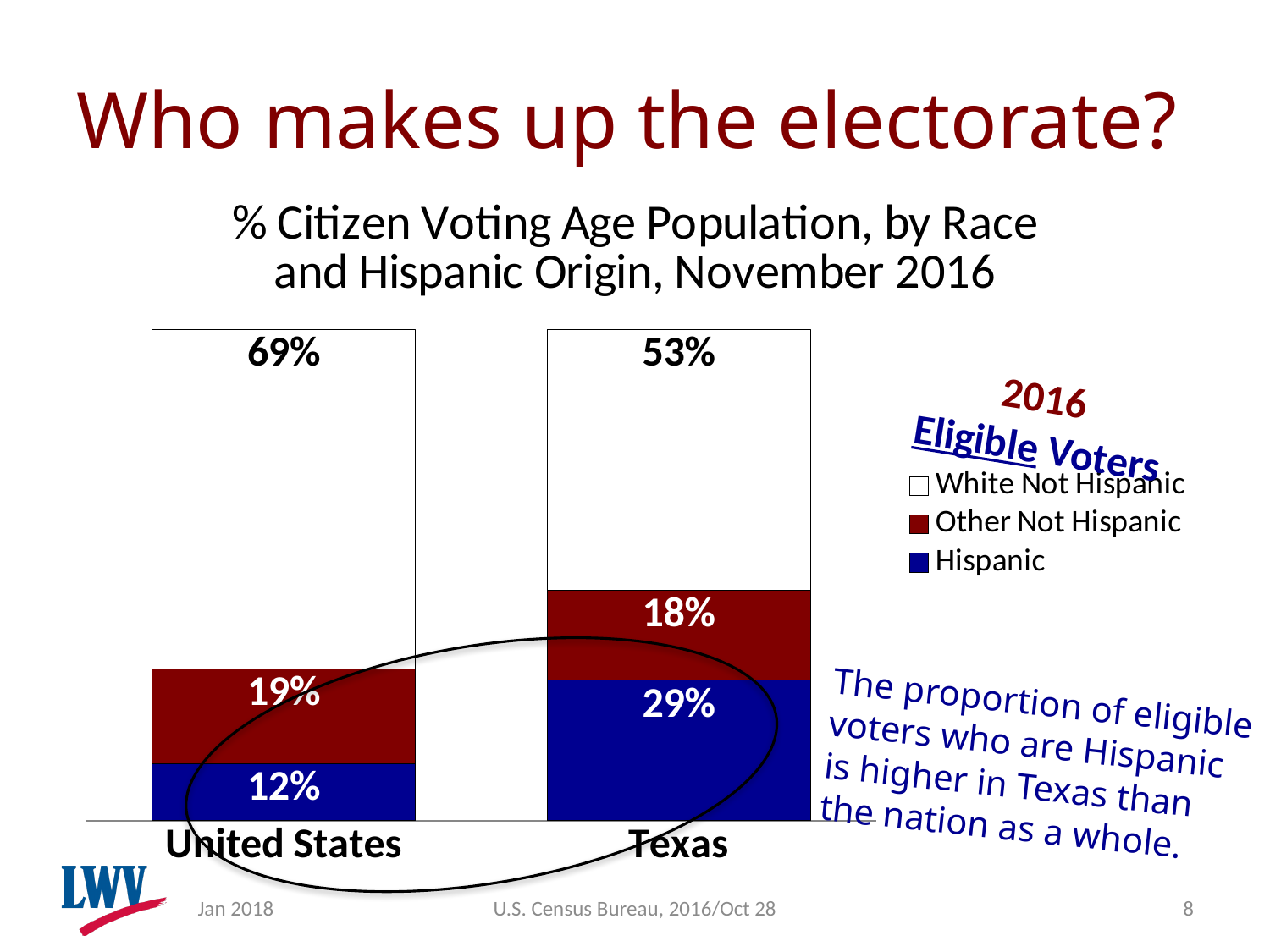
How much higher is the Hispanic share in Texas than in the United States? 17 percentage points How many series does the legend list? 3 Which category has the smallest share in the United States? Hispanic What percentage of the citizen voting age population in Texas is Hispanic? 29% Which category has the largest share in Texas? White Not Hispanic What is the Other Not Hispanic share for Texas? 18% What is the Hispanic share for the United States? 12% What percentage of the citizen voting age population in the United States is White Not Hispanic? 69% How many categories are shown on the x axis? 2 What colour represents Hispanic in the chart? Blue Which has a larger White Not Hispanic share, the United States or Texas? United States What kind of chart is shown? Stacked bar chart